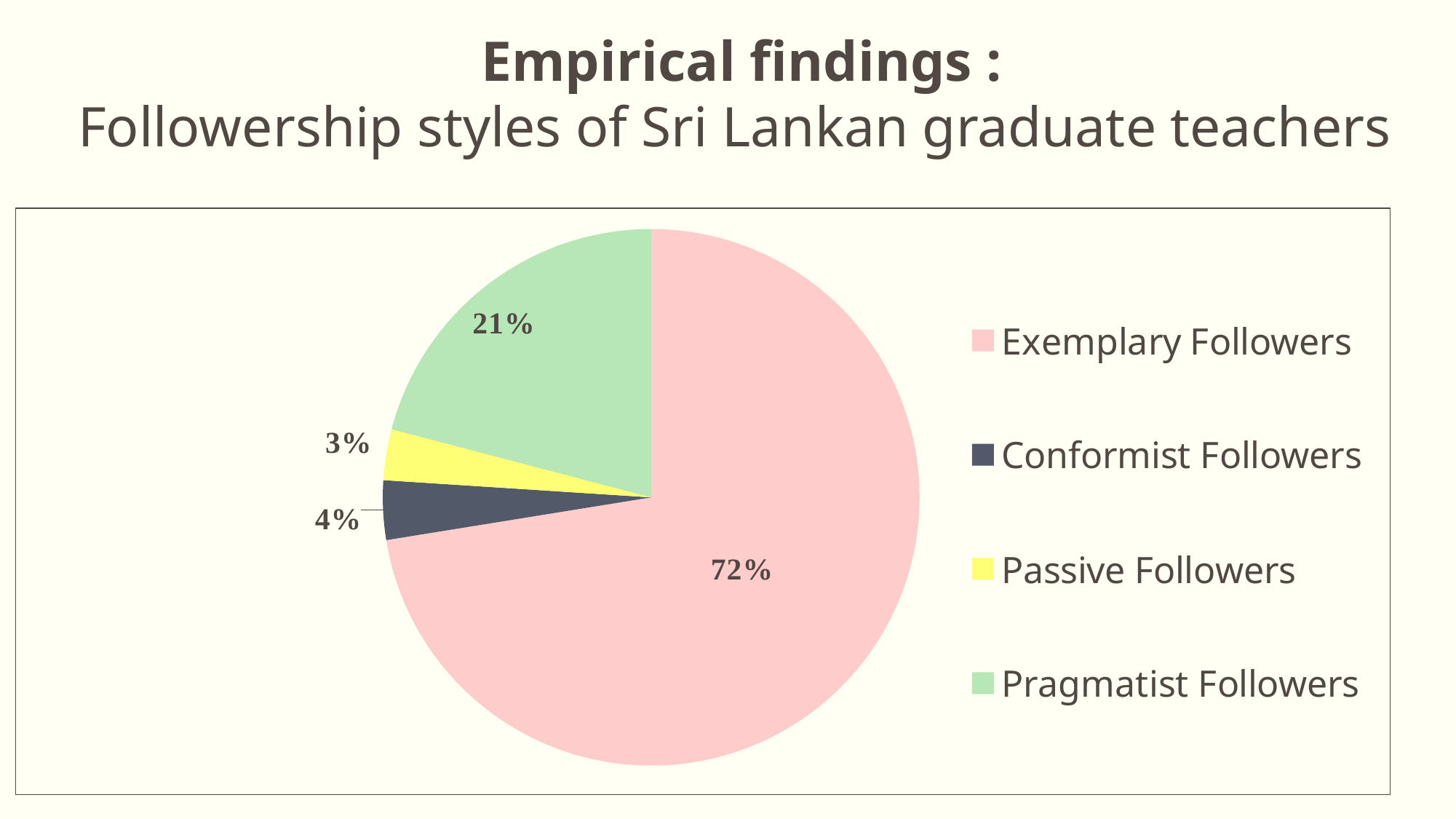
What colour is the Passive Followers slice? Yellow What share of the pie is Exemplary Followers? 72% Which followership style has the largest share? Exemplary Followers How many slices does the pie chart have? 4 What share of the pie is Passive Followers? 3% What share of the pie is Pragmatist Followers? 21% Which is larger, the share of Pragmatist Followers or Conformist Followers? Pragmatist Followers What kind of chart is shown on the slide? Pie chart What is the difference between the shares of Exemplary Followers and Pragmatist Followers? 51% What is the difference between the shares of Conformist Followers and Passive Followers? 1% Which followership style has the smallest share? Passive Followers